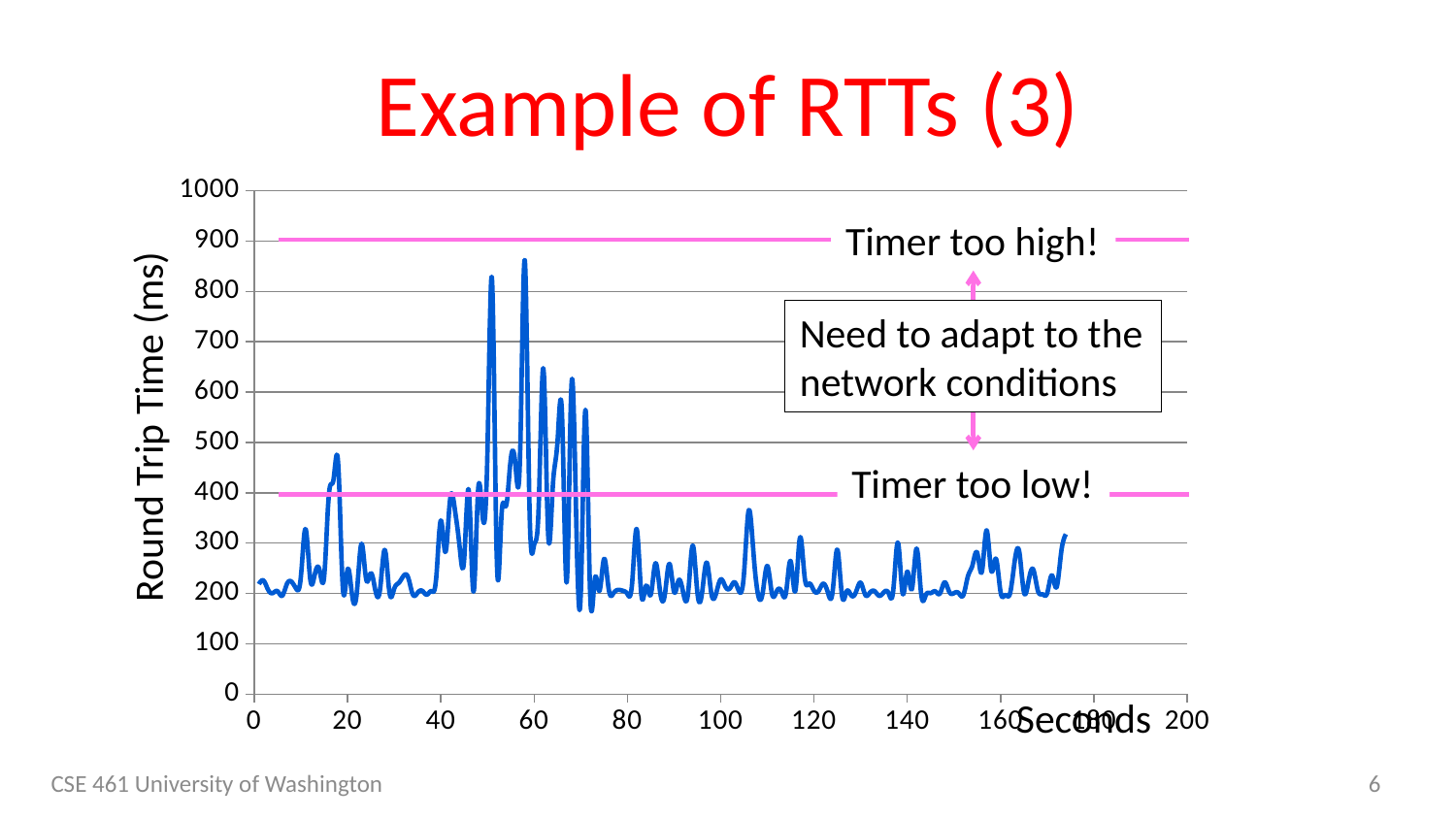
What is the label of the horizontal axis of the chart? Seconds Is the pink line labelled 'Timer too high!' greater or less than 800 on the vertical axis? greater Is the round trip time higher at around 58 seconds or at around 100 seconds? around 58 seconds Is the highest peak of the round trip time line greater or less than 800? greater What kind of chart is shown on the slide? line chart Is the pink line labelled 'Timer too low!' greater or less than 500 on the vertical axis? less What is the highest value shown on the vertical axis of the chart? 1000 What is the label of the vertical axis of the chart? Round Trip Time (ms)